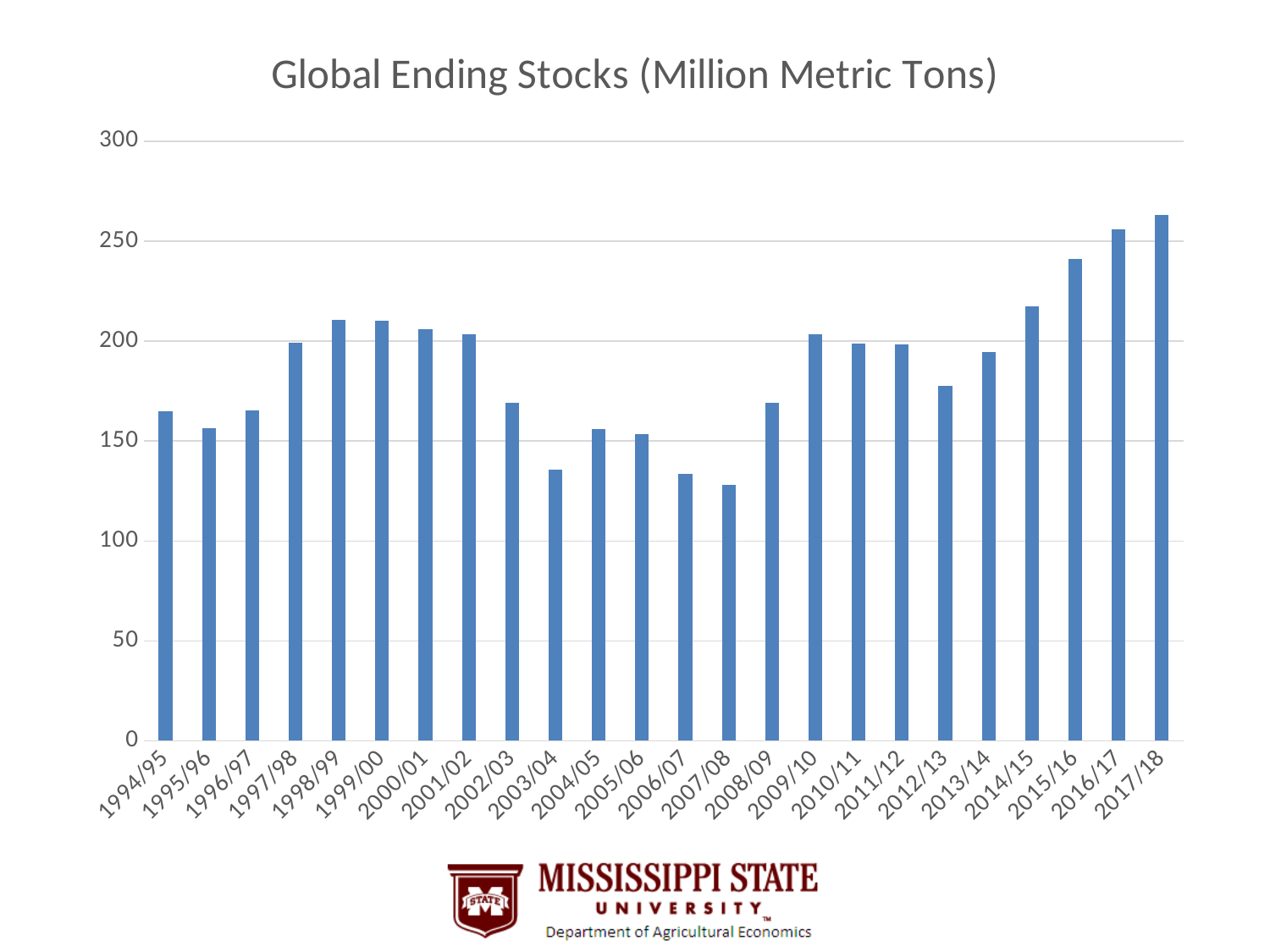
Is the value for 2007/08 greater or less than 150? less What kind of chart is shown on the slide? bar chart Which year has the larger value, 2013/14 or 2014/15? 2014/15 Is the value for 2003/04 greater or less than 150? less Which year has the highest global ending stocks? 2017/18 Do the values rise or fall from 2012/13 to 2017/18? rise Is the value for 1998/99 greater or less than 200? greater Which year has the lowest global ending stocks? 2007/08 What is the title of the chart? Global Ending Stocks (Million Metric Tons) How many marketing years are plotted on the x axis? 24